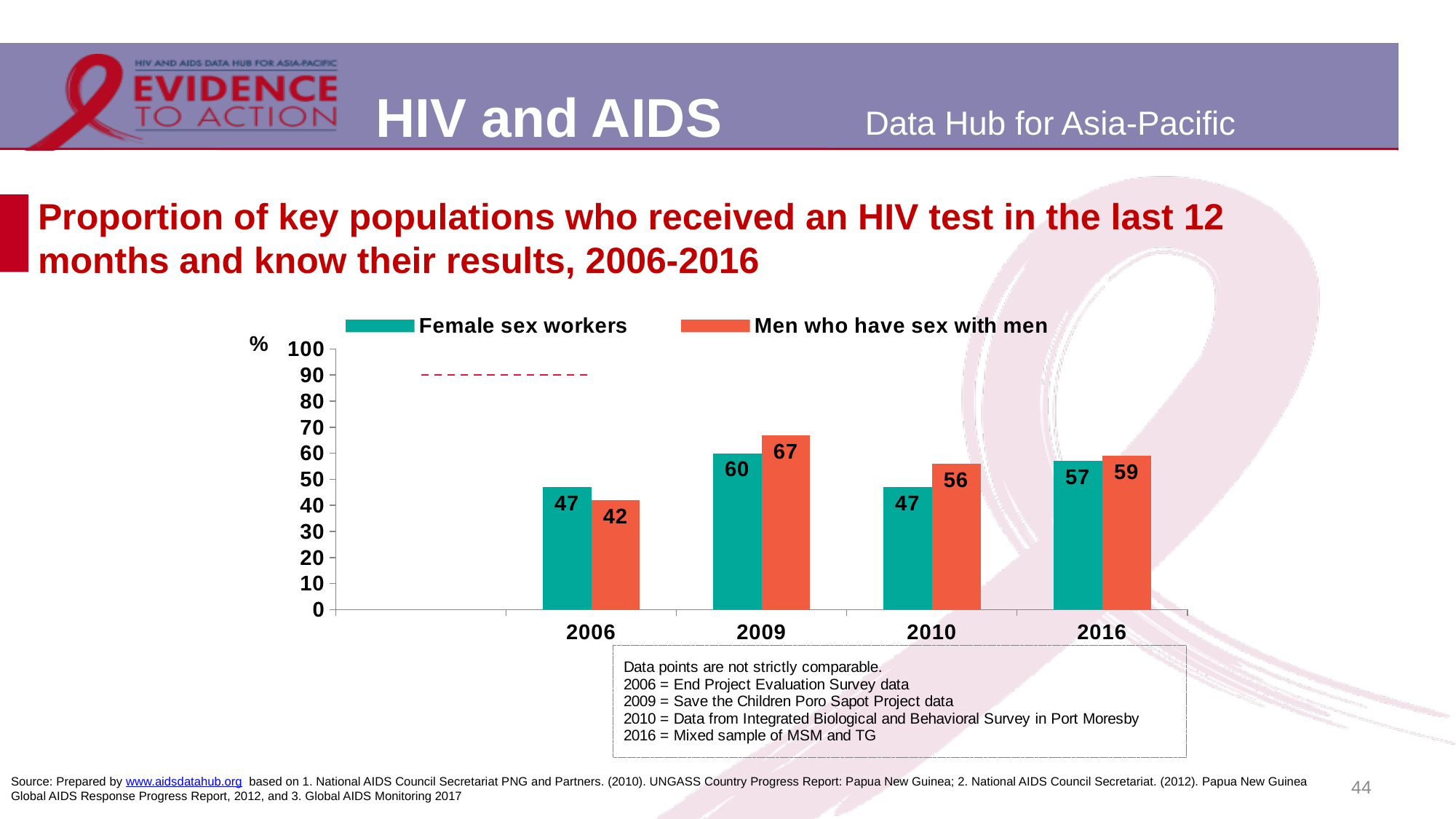
What is the value for Men who have sex with men in 2006? 42 What is the value for Female sex workers in 2009? 60 In which year is the value for Men who have sex with men lowest? 2006 What is the value for Female sex workers in 2010? 47 In which year is the value for Men who have sex with men highest? 2009 What is the value for Men who have sex with men in 2016? 59 How many series does the legend list? 2 In 2006, which series has the larger value, Female sex workers or Men who have sex with men? Female sex workers How many years are shown on the x axis? 4 What unit is shown on the y axis label? % What is the difference between the Men who have sex with men value and the Female sex workers value in 2010? 9 What kind of chart is shown on the slide? Bar chart